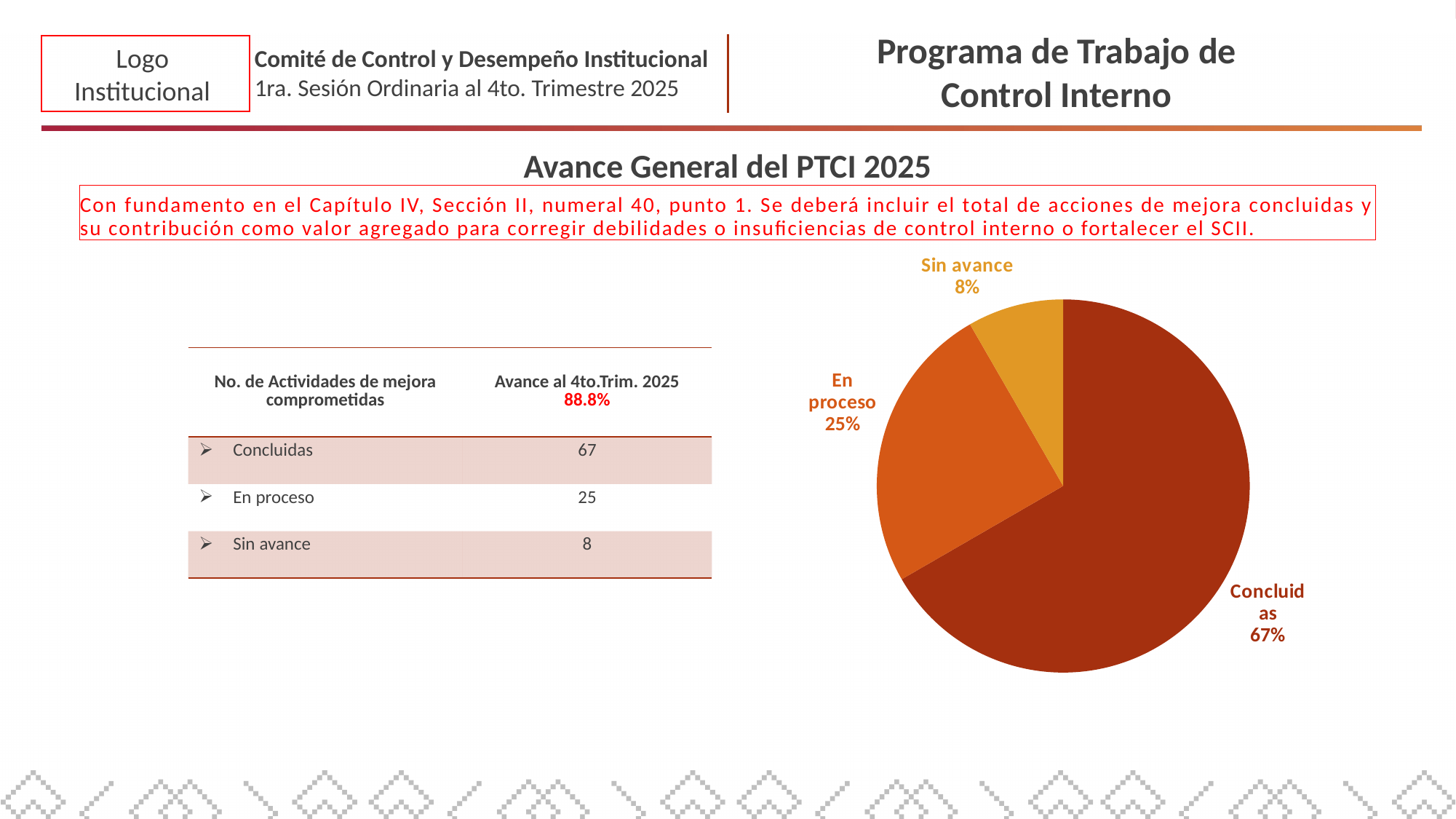
What is the difference in percentage points between the Concluidas and En proceso slices of the pie chart? 42 What percentage is shown for the Concluidas slice of the pie chart? 67% What percentage is shown for the En proceso slice of the pie chart? 25% What percentage is shown for the Sin avance slice of the pie chart? 8% Which slice of the pie chart is the smallest? Sin avance What share of the pie chart does the Concluidas slice represent? 67% What kind of chart is shown on the slide? pie chart Which slice is larger in the pie chart, En proceso or Sin avance? En proceso Which slice of the pie chart is the largest? Concluidas How many slices does the pie chart have? 3 What colour is the Sin avance slice of the pie chart? yellow-orange What is the difference in percentage points between the En proceso and Sin avance slices of the pie chart? 17